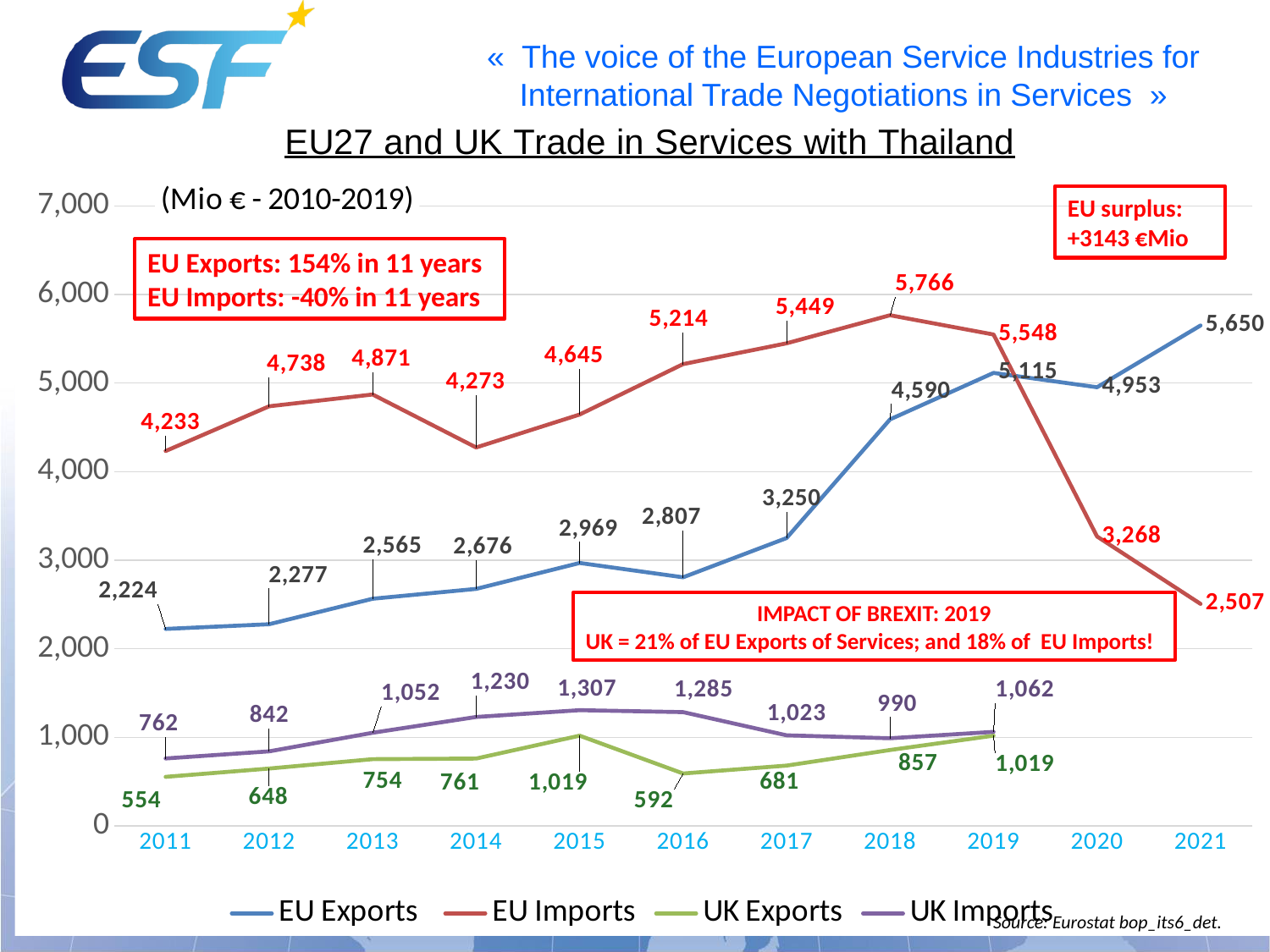
What is the value of EU Exports in 2021? 5,650 What type of chart is shown on the slide? line chart What is the value of UK Imports in 2015? 1,307 In which year do EU Imports reach their highest value? 2018 In 2019, which is larger: EU Exports or EU Imports? EU Imports What is the value of EU Imports in 2018? 5,766 Do EU Imports rise or fall from 2019 to 2021? fall How many years are shown on the x axis? 11 What is the difference between EU Exports and EU Imports in 2021? 3,143 In which year are UK Exports at their lowest? 2011 What is the title of the chart? EU27 and UK Trade in Services with Thailand How many series does the legend list? 4